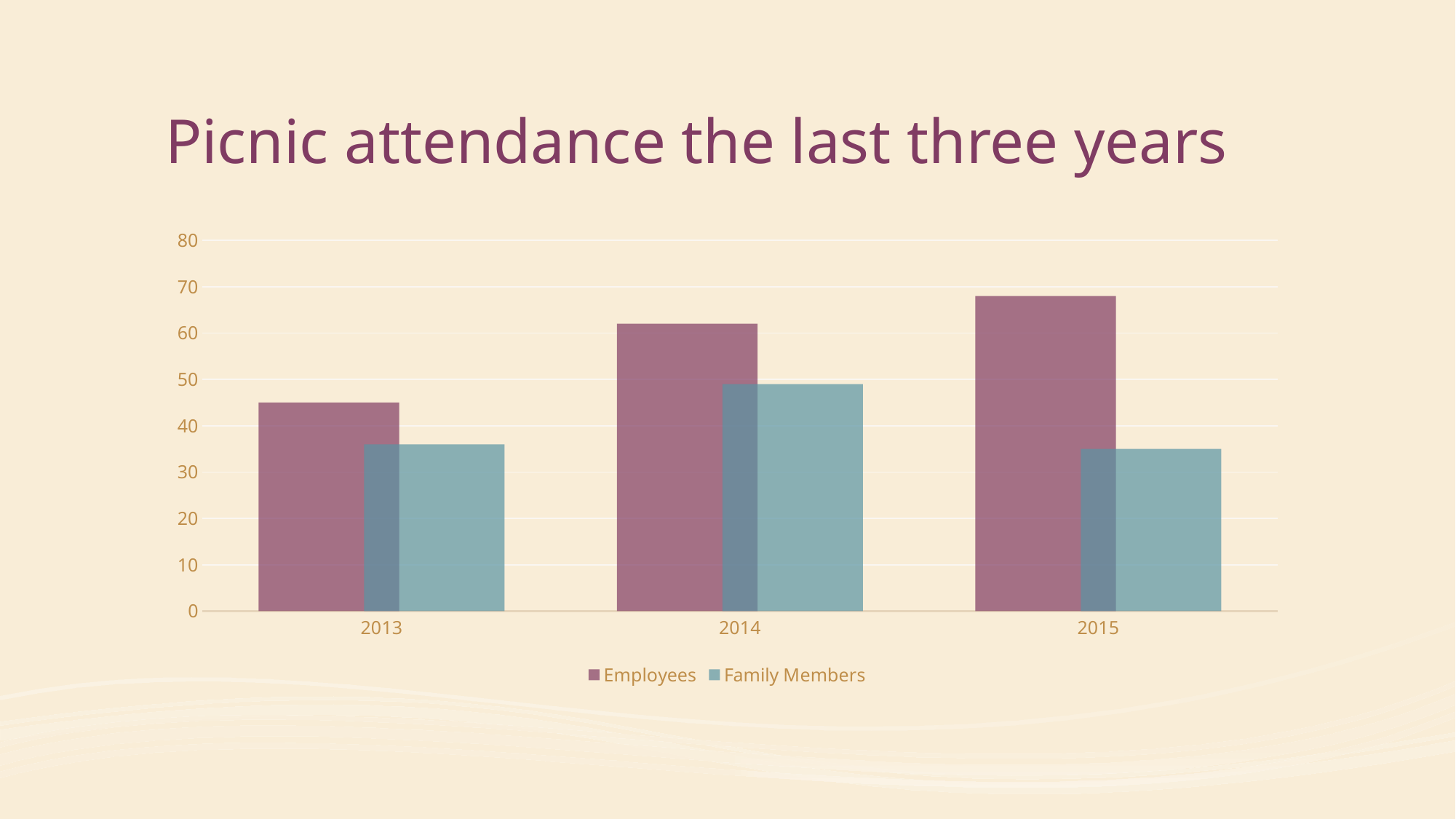
How many series does the legend list? 2 Is the Family Members value for 2014 greater or less than 40? greater How many years are shown on the x axis? 3 In which year is the Employees value highest? 2015 Is the Employees value for 2015 greater or less than 70? less Is the Employees value for 2013 greater or less than 40? greater In which year is the Employees value lowest? 2013 Do the Employees values rise or fall from 2013 to 2015? rise In 2015, which is larger: Employees or Family Members? Employees What kind of chart is shown on the slide? bar chart In which year is the Family Members value highest? 2014